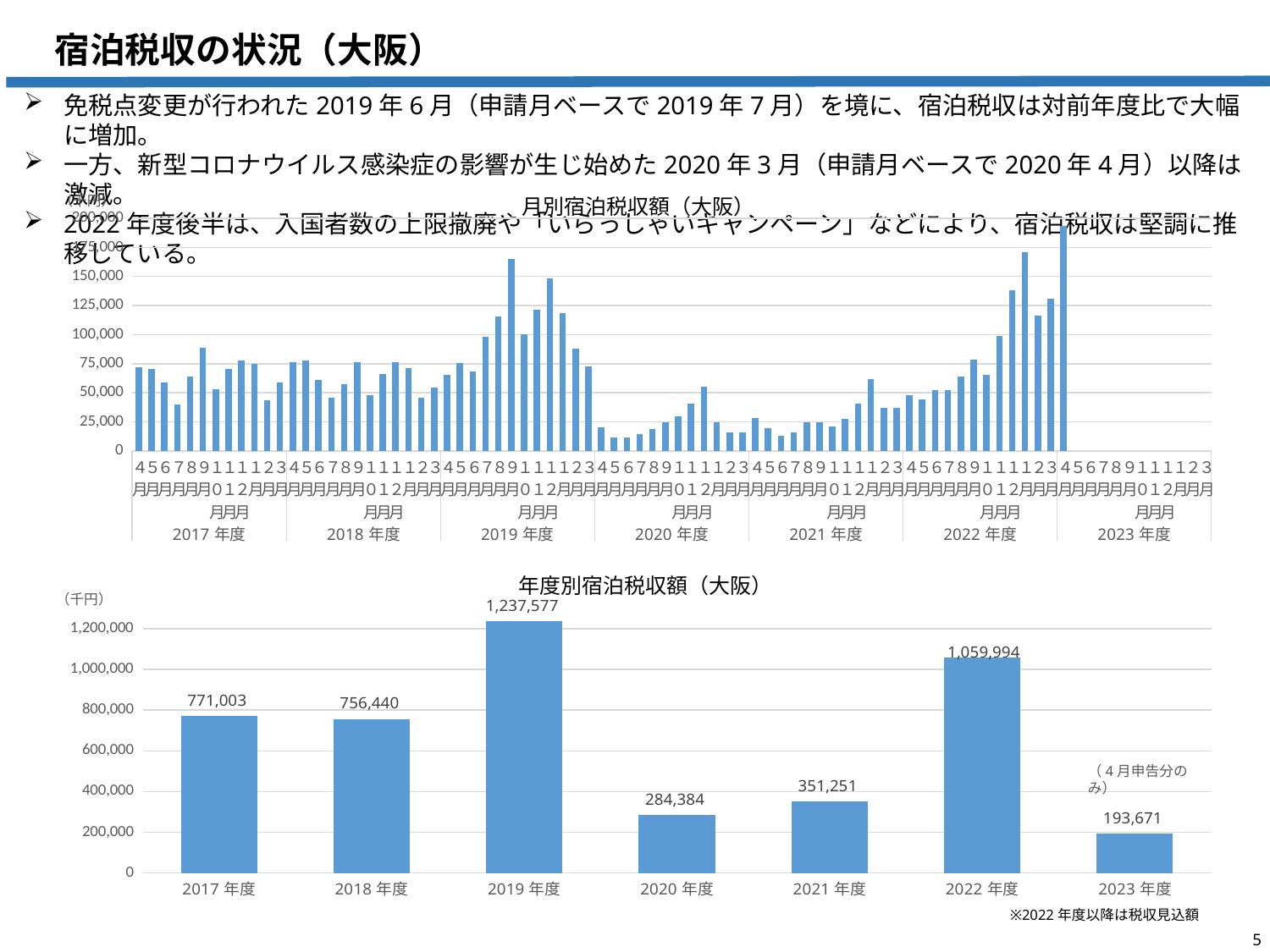
In the top chart 月別宿泊税収額（大阪）, is the value for 4月 of 2020年度 greater or less than 25,000? less In the bottom chart 年度別宿泊税収額（大阪）, what is the value for 2019年度? 1,237,577 In the top chart 月別宿泊税収額（大阪）, is the value for 8月 of 2019年度 greater or less than 150,000? less In the bottom chart 年度別宿泊税収額（大阪）, which is larger, the value for 2017年度 or 2018年度? 2017年度 What kind of chart is the bottom chart 年度別宿泊税収額（大阪）? Bar chart In the bottom chart 年度別宿泊税収額（大阪）, what is the value for 2023年度? 193,671 In the bottom chart 年度別宿泊税収額（大阪）, which fiscal year has the highest value? 2019年度 In the bottom chart 年度別宿泊税収額（大阪）, what is the value for 2020年度? 284,384 In the bottom chart 年度別宿泊税収額（大阪）, what is the difference between the values for 2022年度 and 2021年度? 708,743 In the bottom chart 年度別宿泊税収額（大阪）, how many fiscal years are plotted? 7 What unit is shown on the vertical axis of the bottom chart 年度別宿泊税収額（大阪）? 千円 In the bottom chart 年度別宿泊税収額（大阪）, which fiscal year has the lowest value? 2023年度